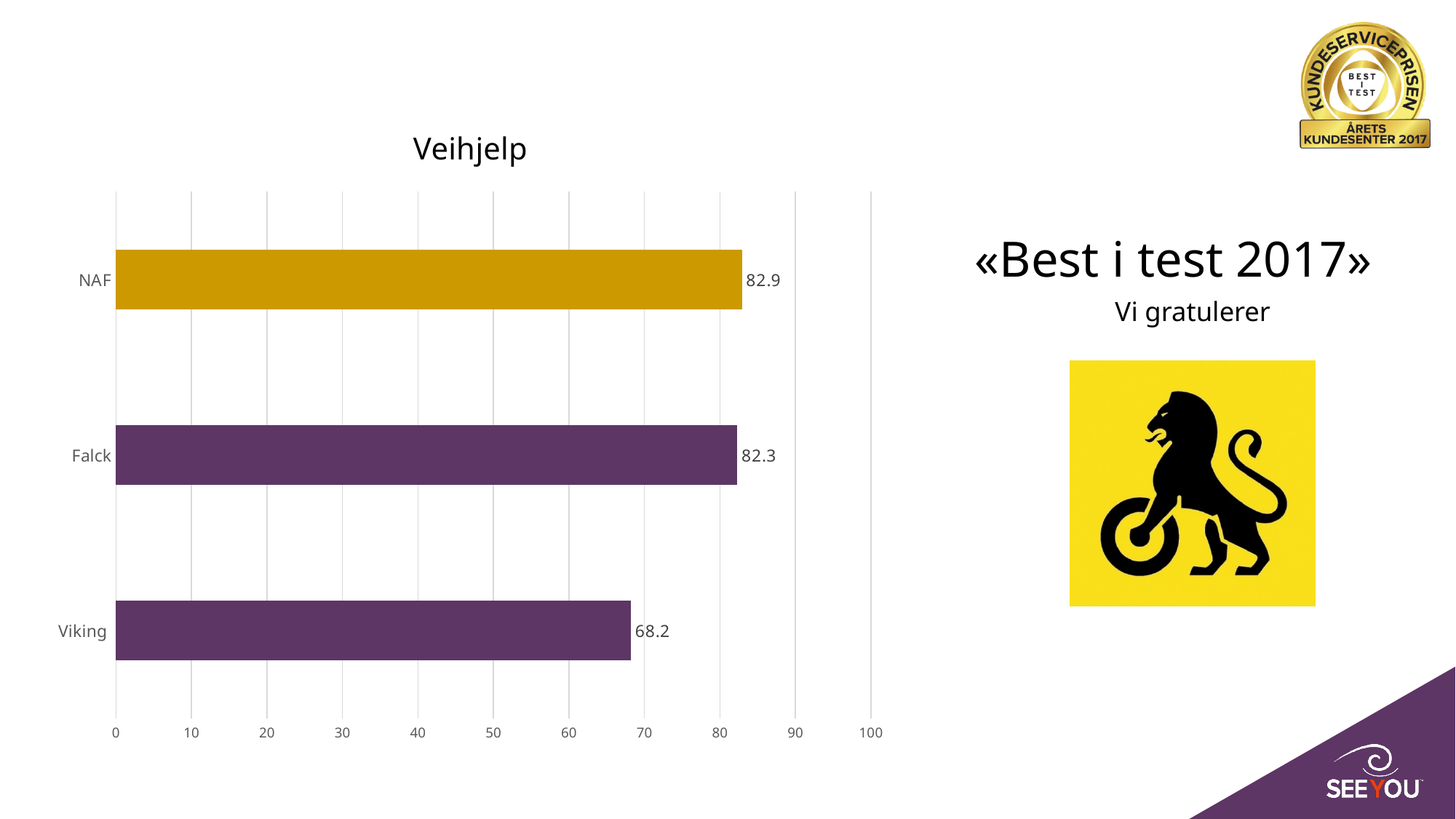
Which has a larger value, Falck or Viking? Falck Which category has the highest value? NAF What is the value for Viking? 68.2 What is the value for Falck? 82.3 What is the difference between the values for NAF and Viking? 14.7 How many categories are shown in the chart? 3 Is the value for Viking greater or less than 70? less What is the value for NAF? 82.9 Which category has the lowest value? Viking What is the title of the chart? Veihjelp What kind of chart is shown on the slide? bar chart What is the difference between the values for Falck and Viking? 14.1